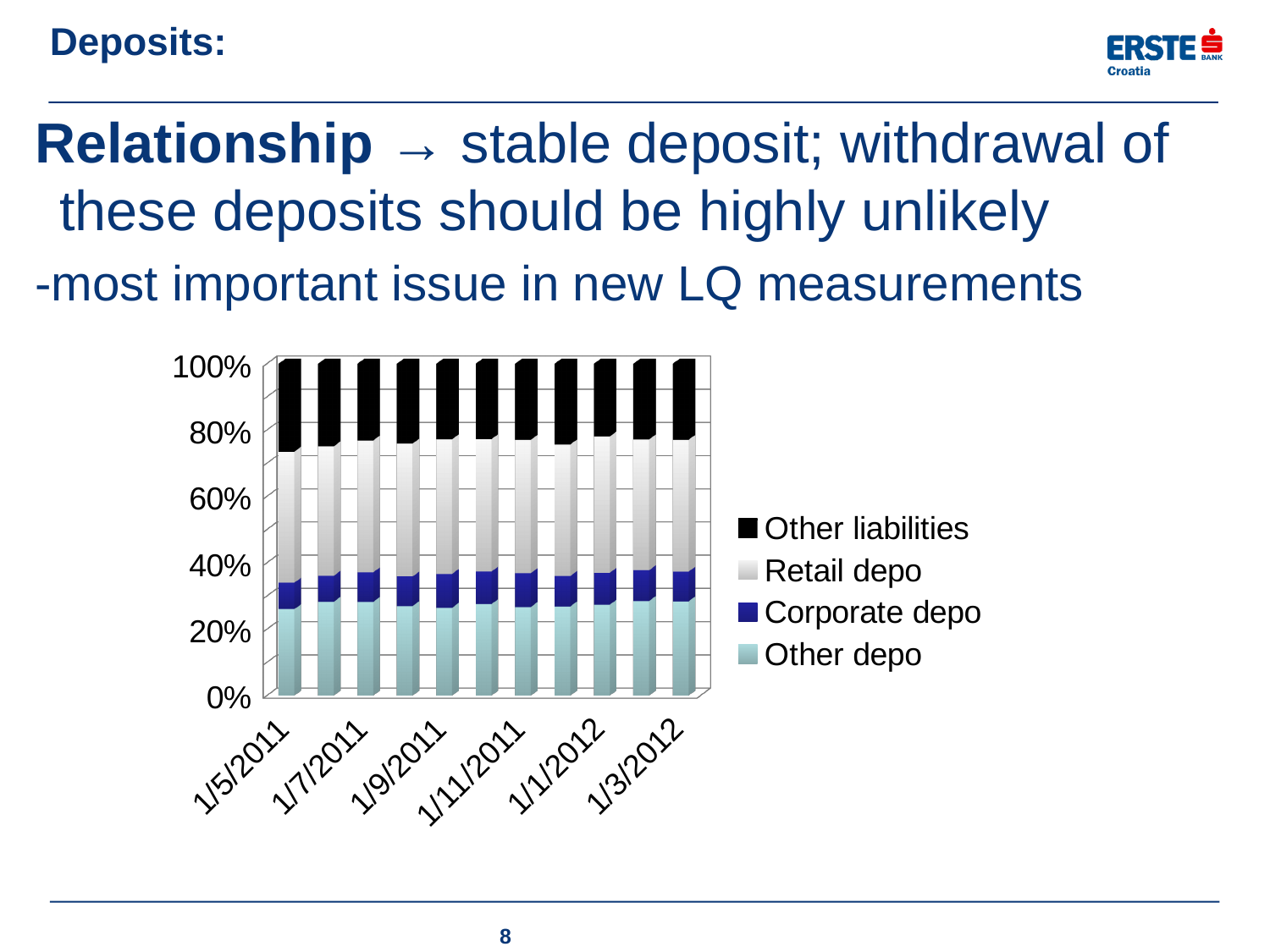
Which is larger for 1/5/2011, the Retail depo segment or the Corporate depo segment? Retail depo What is the total height of each stacked bar on the percentage axis? 100% Is the Other depo value for 1/5/2011 greater or less than 40%? less Is the cumulative top of the Retail depo segment for 1/5/2011 greater or less than 60%? greater What kind of chart is shown on the slide? stacked bar chart Which series is shown in black in the chart? Other liabilities Is the Other depo value for 1/5/2011 greater or less than 20%? greater Which series is at the bottom of each stacked bar? Other depo How many bars are plotted in the chart? 11 What is the first date label shown on the x axis? 1/5/2011 How many series does the chart legend list? 4